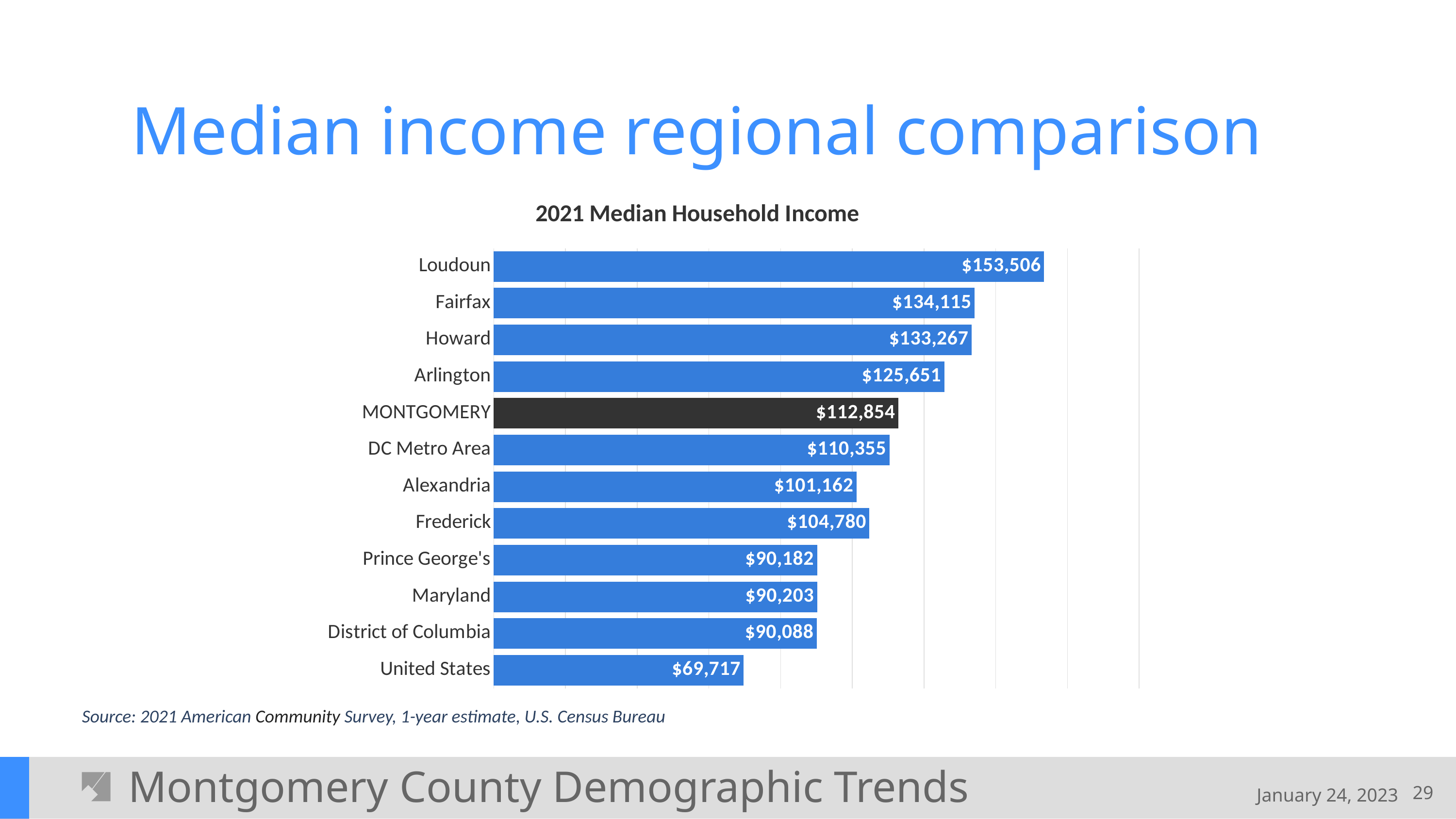
What is the 2021 median household income for Loudoun? $153,506 What is the 2021 median household income for the United States? $69,717 Which bar is shown in a different (dark) colour from the others? MONTGOMERY What is the difference between MONTGOMERY's median household income and the United States'? $43,137 Which region has the lowest 2021 median household income? United States How many regions are shown in the chart? 12 Which region has the highest 2021 median household income? Loudoun Which has a higher median household income, Frederick or Alexandria? Frederick How much higher is Loudoun's median household income than MONTGOMERY's? $40,652 What is the 2021 median household income for MONTGOMERY? $112,854 What is the 2021 median household income for Frederick? $104,780 What type of chart is shown on the slide? Bar chart